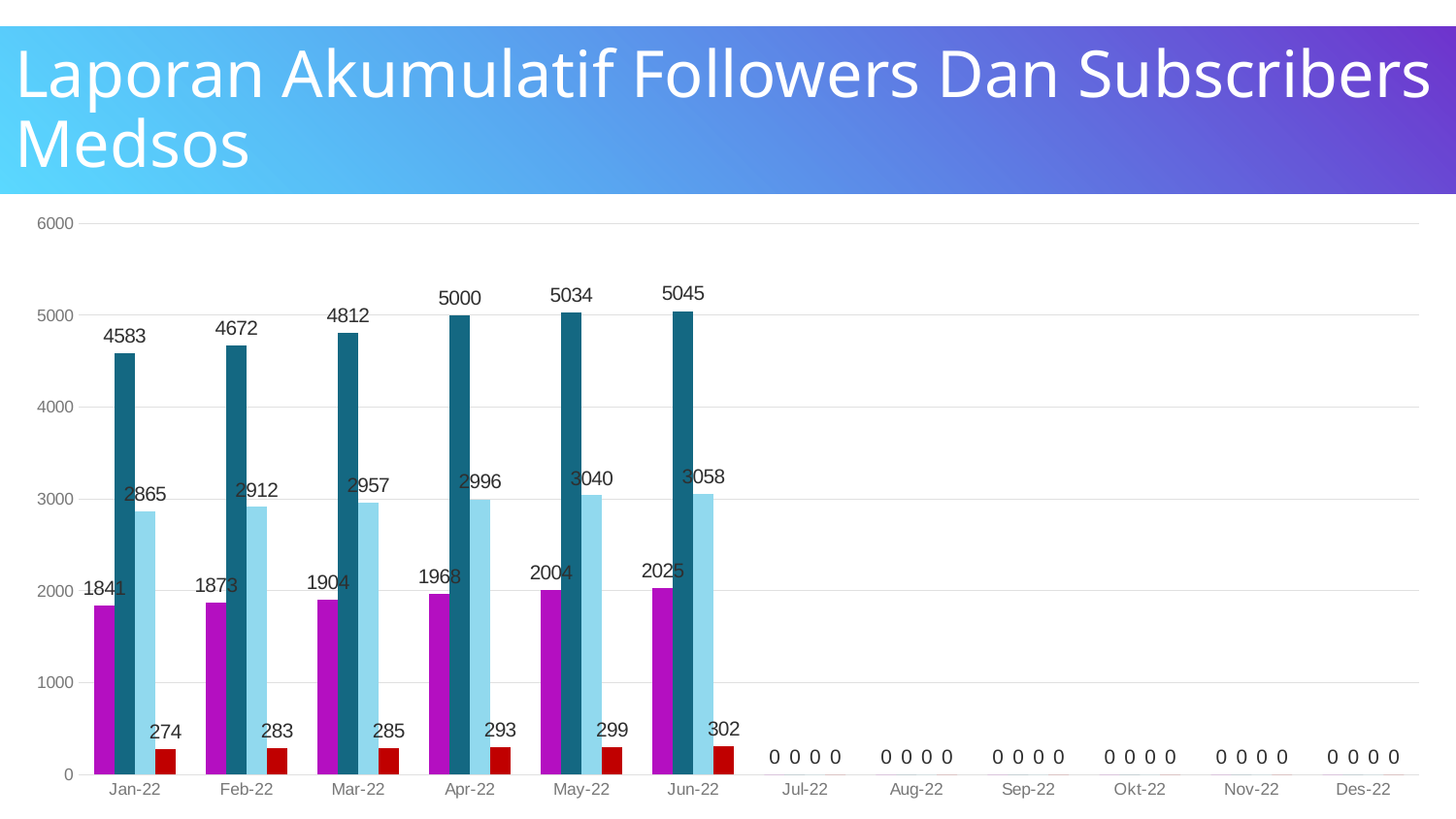
Do the values of the light blue series rise or fall from Jan-22 to Jun-22? rise What type of chart is shown on the slide? bar chart What values are shown for Jul-22 through Des-22? 0 What is the difference between the dark teal values for Jun-22 and Jan-22? 462 What is the value of the red bar for May-22? 299 Which month has the lowest value for the purple series among the months with non-zero values? Jan-22 Which is larger for Mar-22: the light blue bar or the purple bar? the light blue bar What is the value of the purple bar for Jan-22? 1841 In which month does the dark teal series reach its highest value? Jun-22 What is the value of the light blue bar for Jun-22? 3058 What is the value of the dark teal bar for Apr-22? 5000 How many months are shown on the x axis? 12